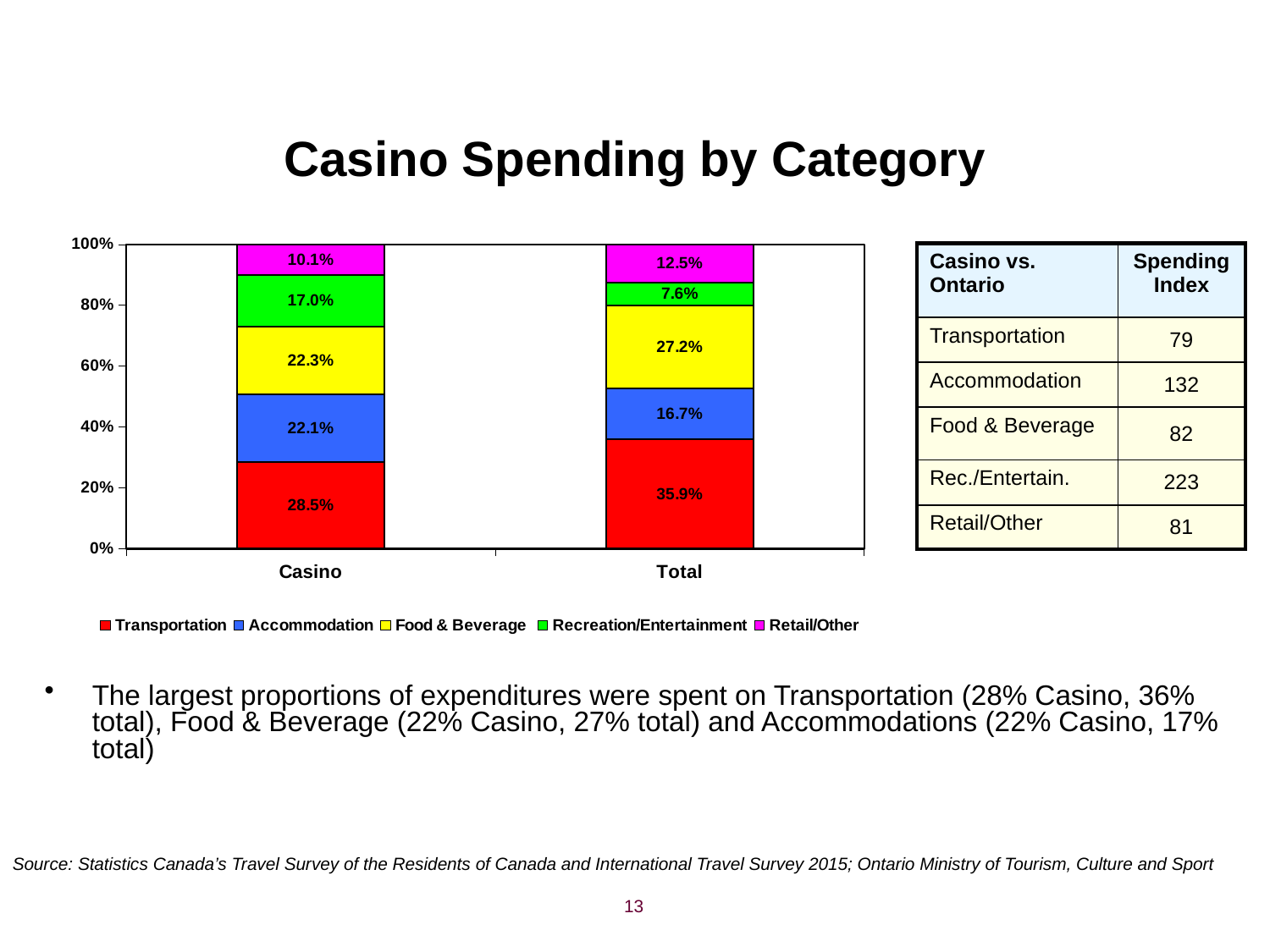
What kind of chart is shown? Stacked bar chart Which category has the smallest share in the Total bar? Recreation/Entertainment What is the difference between the Transportation share for Total and for Casino? 7.4% Is the Accommodation share larger for Casino or for Total? Casino Which colour represents Food & Beverage in the chart? Yellow What is the Retail/Other share for Total? 12.5% Which category has the largest share in the Total bar? Transportation How many bars are shown on the x axis? 2 What is the Recreation/Entertainment share for Casino? 17.0% What is the Food & Beverage share for Total? 27.2% What is the Transportation share for Casino? 28.5% How many series does the legend list? 5